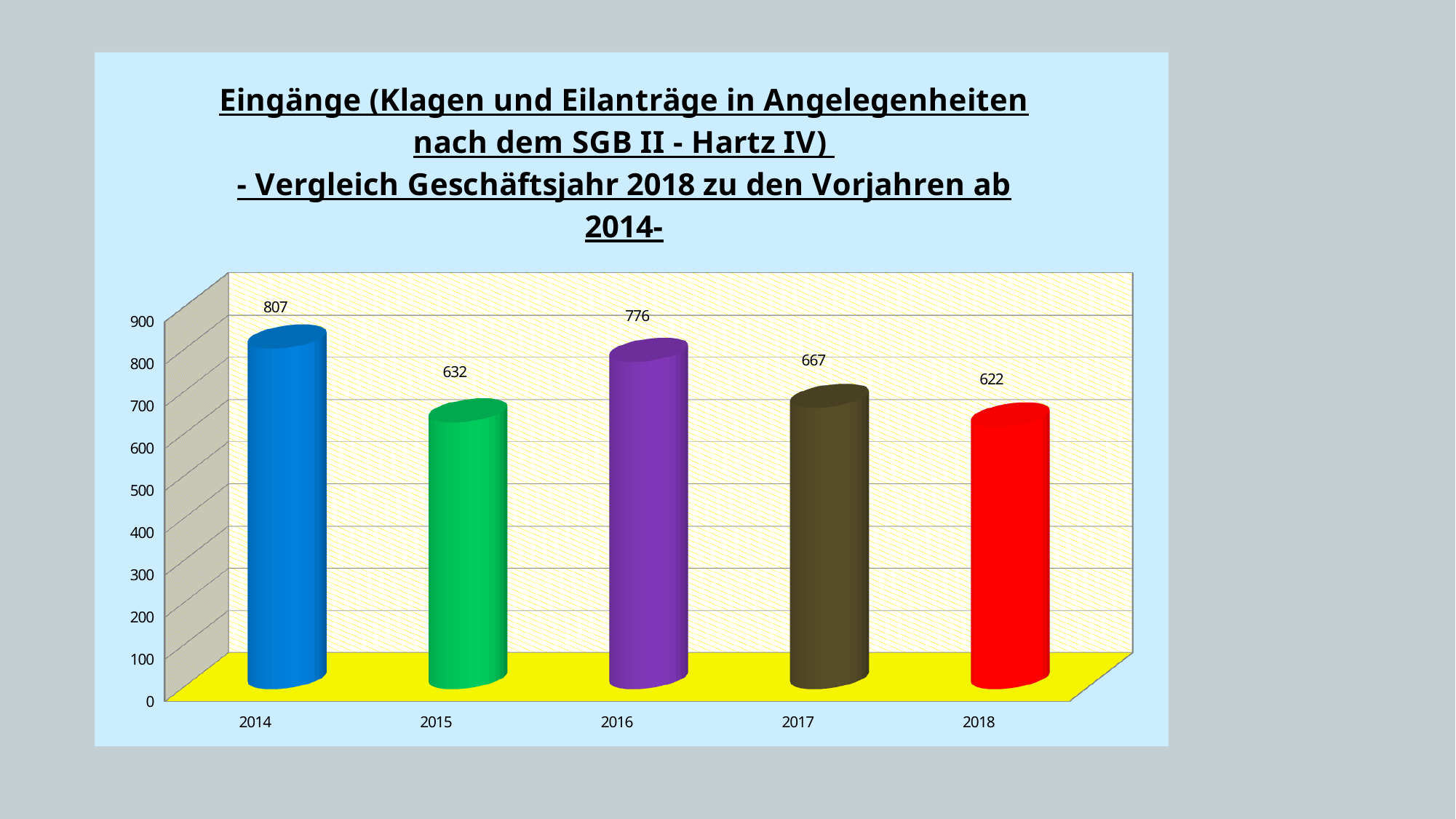
Which year has the lowest value? 2018 Which year has the highest value? 2014 What is the value for 2014? 807 What is the difference between the values for 2014 and 2018? 185 What kind of chart is shown on the slide? bar chart How many years are shown on the x axis? 5 What colour is the bar for 2016? purple Does the value fall or rise from 2016 to 2018? fall Which is larger, the value for 2015 or the value for 2017? 2017 What is the value for 2016? 776 What is the value for 2018? 622 What is the difference between the values for 2016 and 2017? 109